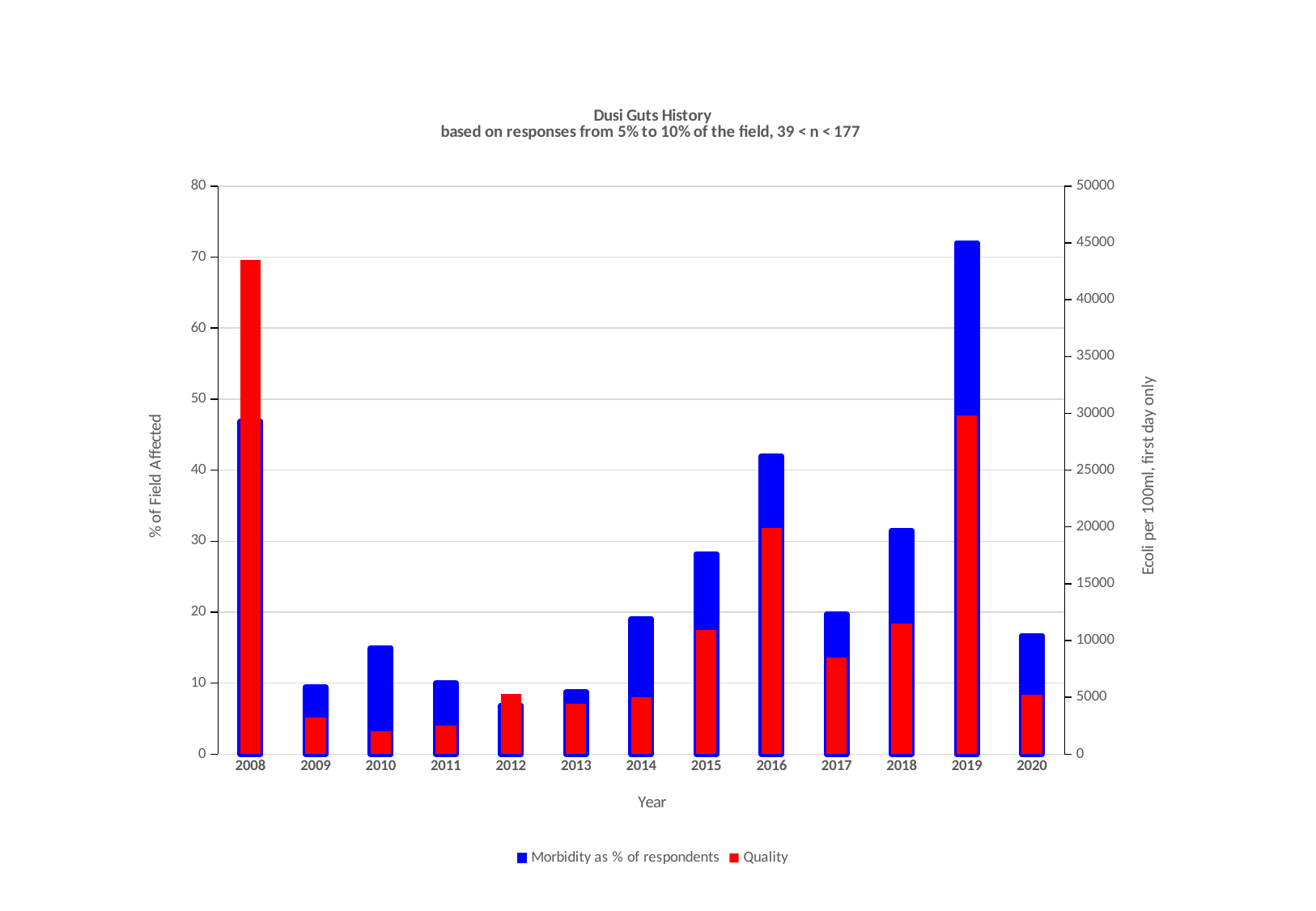
In which year is Morbidity as % of respondents highest? 2019 Is the Morbidity as % of respondents value for 2019 greater or less than 60? greater What is the title of the right-hand vertical axis? Ecoli per 100ml, first day only Which year has the larger Quality value, 2019 or 2016? 2019 In which year is Morbidity as % of respondents lowest? 2012 Is the Morbidity as % of respondents value for 2012 greater or less than 10? less In which year is the Quality (Ecoli) value highest? 2008 Is the Quality value for 2008 greater or less than 40000 Ecoli per 100ml? greater How many series does the legend list? 2 How many years are shown on the x axis? 13 Which year has the larger Morbidity as % of respondents, 2016 or 2018? 2016 What kind of chart is shown on the slide? Bar chart